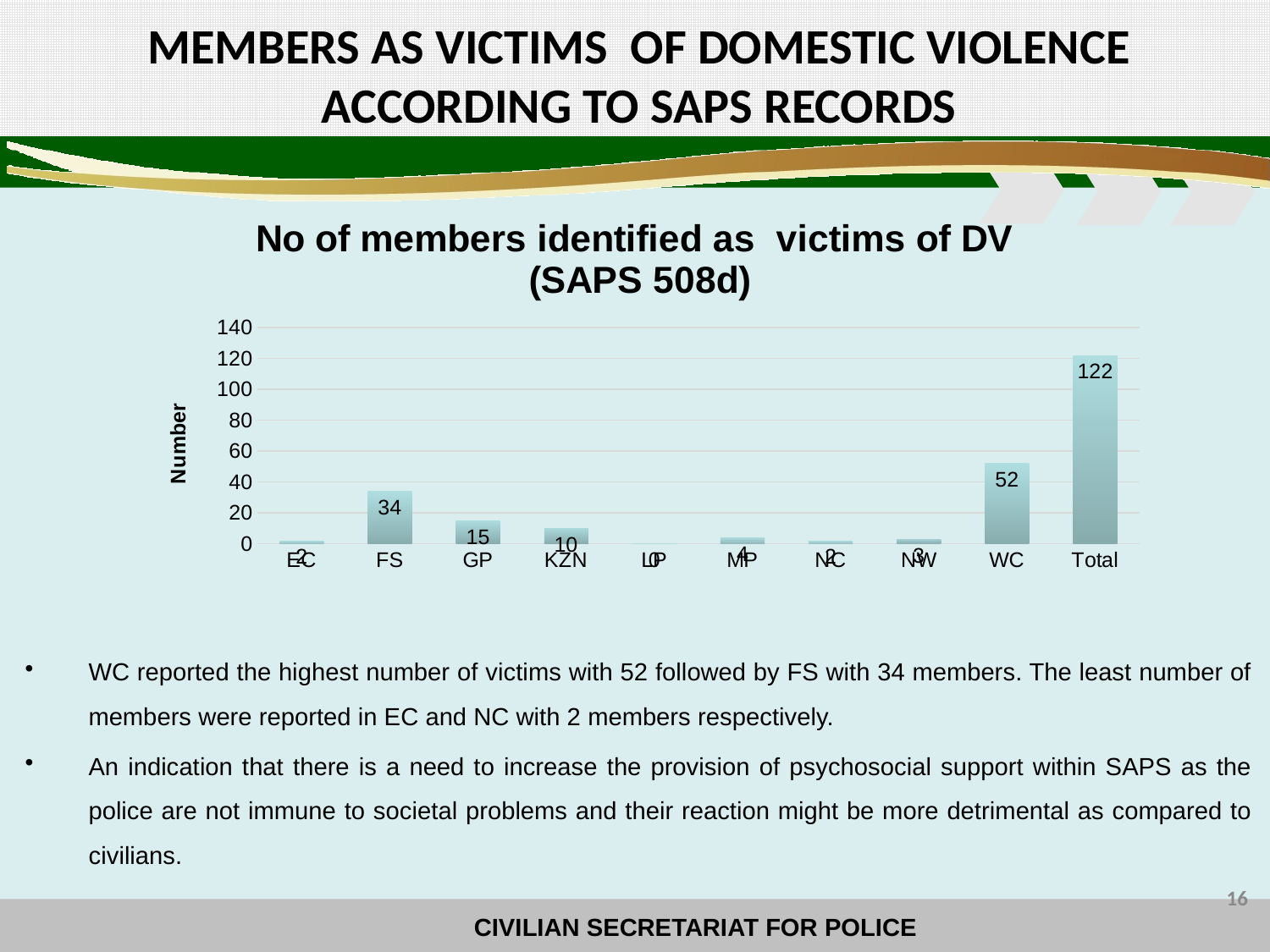
How many categories are shown on the x axis? 10 What is the value of the Total bar? 122 What is the number of members identified as victims of DV for WC? 52 Which province has the highest number of members identified as victims of DV? WC What value is shown for FS? 34 What value is shown for KZN? 10 What is the difference between the values for WC and FS? 18 What is the label of the vertical axis? Number What kind of chart is shown on the slide? Bar chart What value is shown for GP? 15 Which is larger, the value for GP or the value for KZN? GP Is the value for Total greater or less than 100? greater